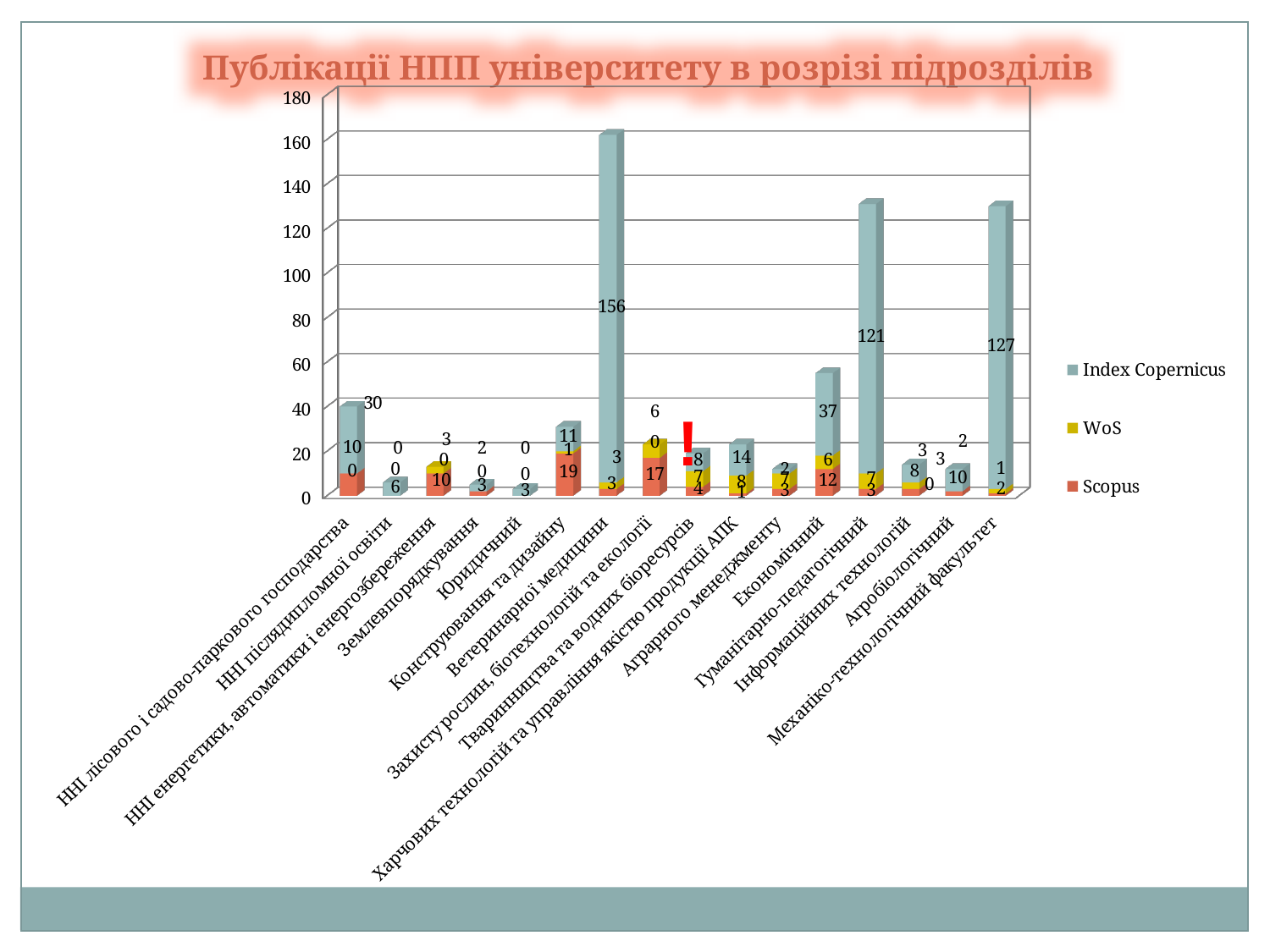
Which has the larger Index Copernicus value: Гуманітарно-педагогічний or Механіко-технологічний факультет? Механіко-технологічний факультет What is the Index Copernicus value for Економічний? 37 What is the Index Copernicus value for Гуманітарно-педагогічний? 121 What is the Scopus value for Конструювання та дизайну? 19 What is the difference between the Index Copernicus values for Ветеринарної медицини and Механіко-технологічний факультет? 29 What is the Index Copernicus value for Ветеринарної медицини? 156 How many departments (categories) are shown on the x axis? 16 What is the title of the chart? Публікації НПП університету в розрізі підрозділів What kind of chart is shown on the slide? bar chart What is the total of the stacked bar for Економічний? 55 How many series does the legend list? 3 Which department has the highest Index Copernicus value? Ветеринарної медицини